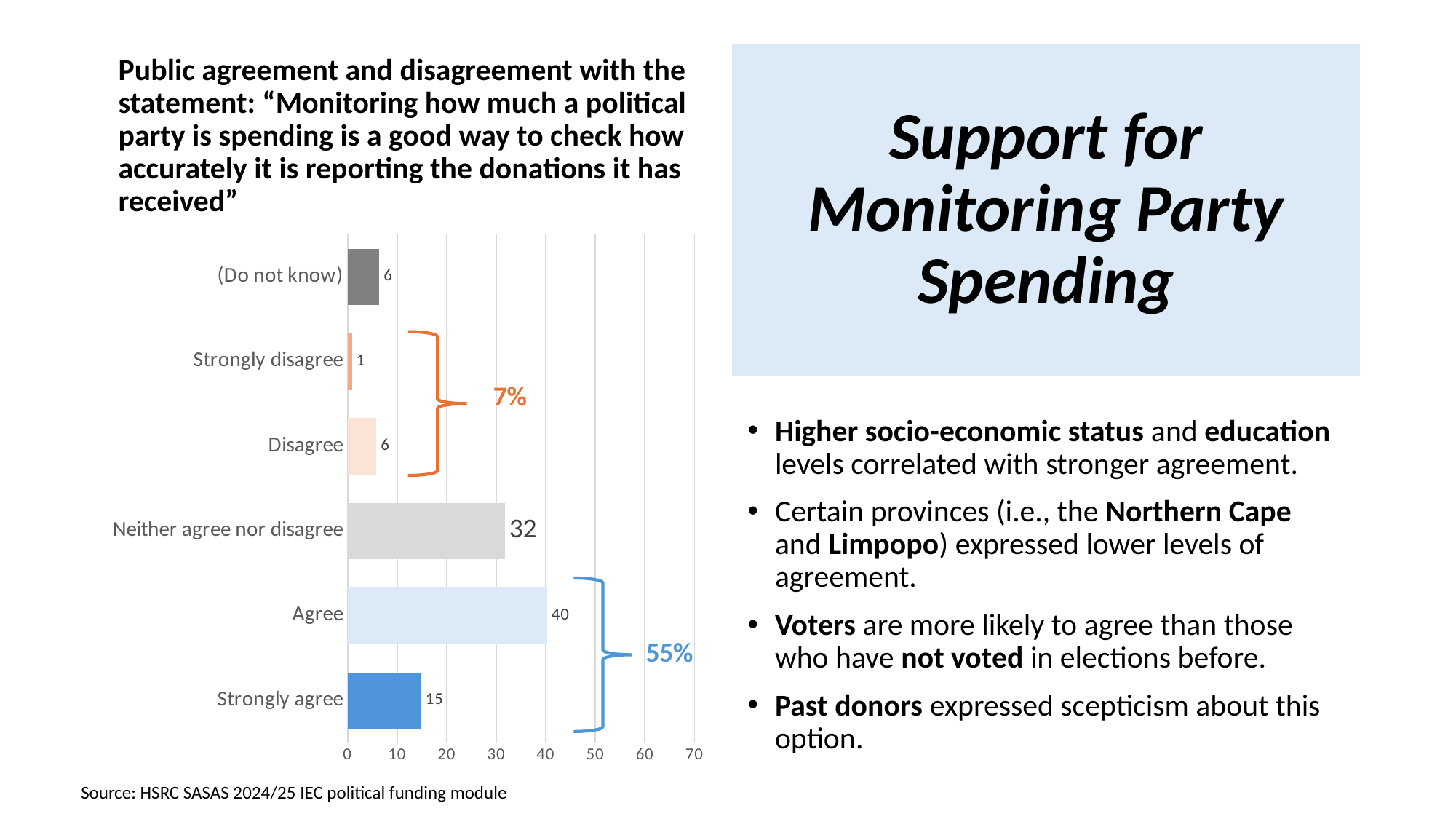
Which category has the highest value? Agree What is the value for Agree? 40 How many categories are shown in the chart? 6 What combined percentage is shown by the bracket grouping Agree and Strongly agree? 55% What is the value for Strongly disagree? 1 What kind of chart is shown on the slide? Bar chart What combined percentage is shown by the bracket grouping Disagree and Strongly disagree? 7% Which is larger, the value for Strongly agree or the value for Disagree? Strongly agree What is the value for Neither agree nor disagree? 32 Which category has the lowest value? Strongly disagree What is the difference between the values for Agree and Neither agree nor disagree? 8 What is the value for Strongly agree? 15